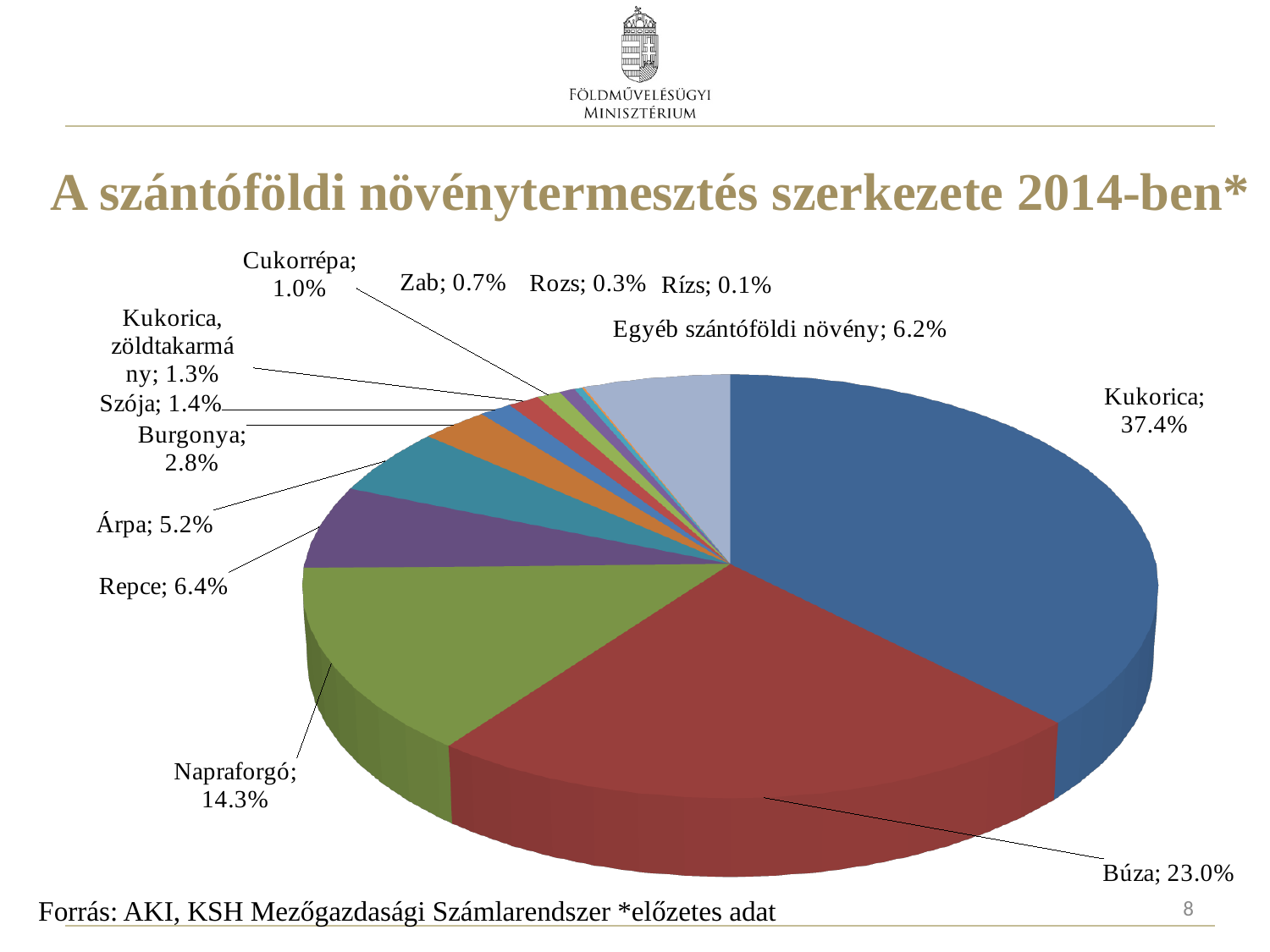
What kind of chart is shown on the slide? pie chart What is the difference in percentage points between Kukorica and Búza? 14.4 Which category has the smallest slice of the pie? Rízs Which is larger, the share for Repce or the share for Árpa? Repce Which category has the largest slice of the pie? Kukorica What is the share for Burgonya? 2.8% What is the share for Búza? 23.0% What is the share for Egyéb szántóföldi növény? 6.2% What is the title of the slide containing the chart? A szántóföldi növénytermesztés szerkezete 2014-ben* What is the share for Napraforgó? 14.3% What is the share for Kukorica? 37.4% How many categories are shown in the pie chart? 13